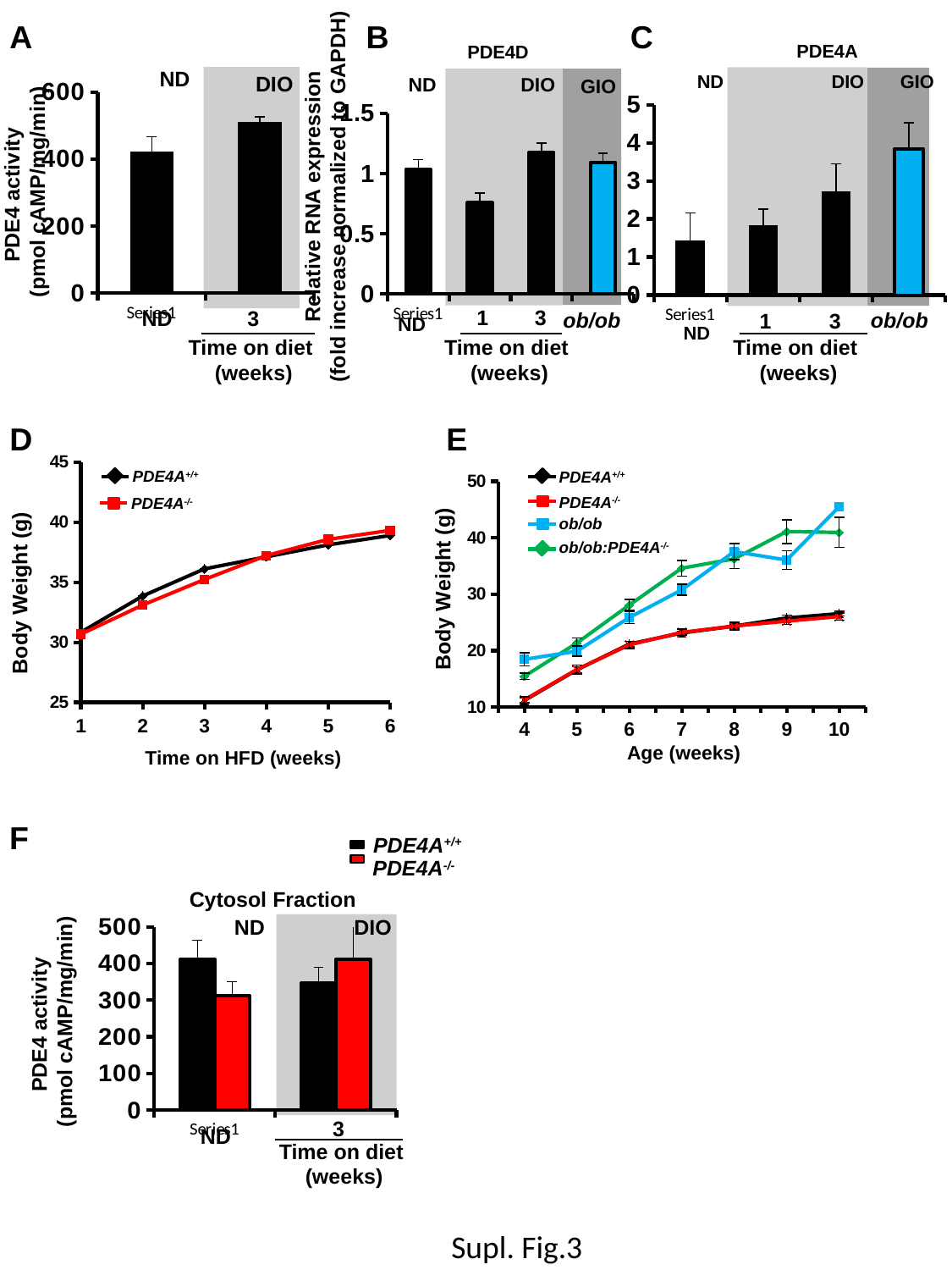
In panel A, is the PDE4 activity for DIO (3 weeks) greater or less than 400? greater What kind of chart is panel D? line chart In panel F (Cytosol Fraction), under ND, which series has the taller bar, PDE4A+/+ or PDE4A-/-? PDE4A+/+ In panel B (PDE4D), which category has the lowest relative RNA expression? 1 week on diet In panel D, does body weight rise or fall as time on HFD increases from week 1 to week 6? rise In panel D, how many series does the legend list? 2 In panel A, which bar is taller, ND or DIO (3 weeks on diet)? DIO In panel B (PDE4D), how many bars are plotted? 4 In panel C (PDE4A), is the value for ob/ob greater or less than 3? greater In panel E, how many series does the legend list? 4 In panel B (PDE4D), is the value for 1 week on diet greater or less than 1? less In panel C (PDE4A), which category has the highest relative RNA expression? ob/ob